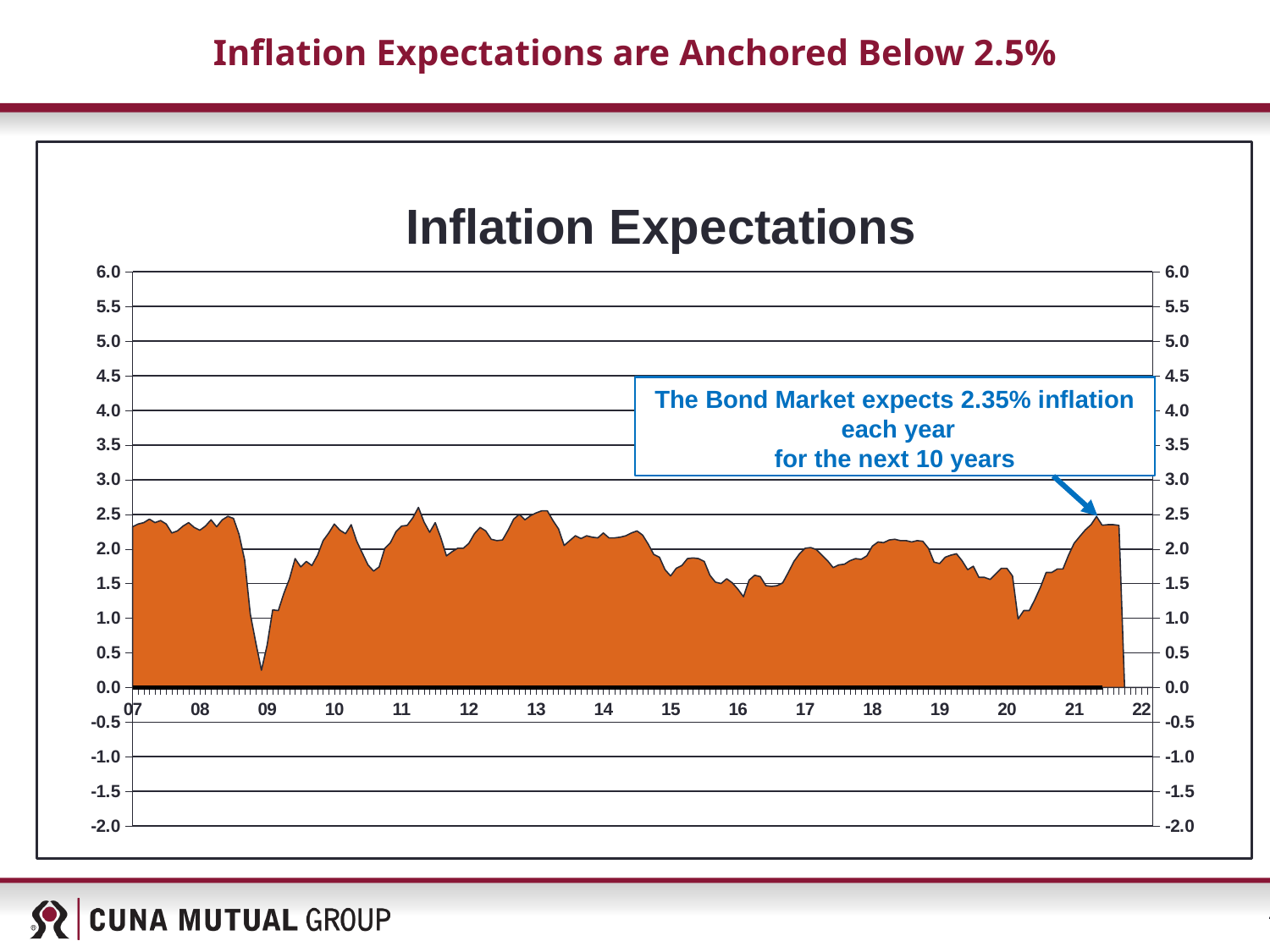
What is the title of the chart? Inflation Expectations Is the value of the series in early 16 greater or less than 1.5? less What type of chart is shown on the slide? area chart Is the lowest value of the series, near the start of 09, greater or less than 0.5? less Does the series rise or fall between 20 and 21? rise Does the series ever rise above 3.0 on the chart? No According to the annotation on the chart, what inflation rate does the bond market expect each year for the next 10 years? 2.35% How many year labels are shown on the x axis? 16 Around which year label does the series reach its lowest point? 09 Does the series rise or fall between 08 and 09? fall